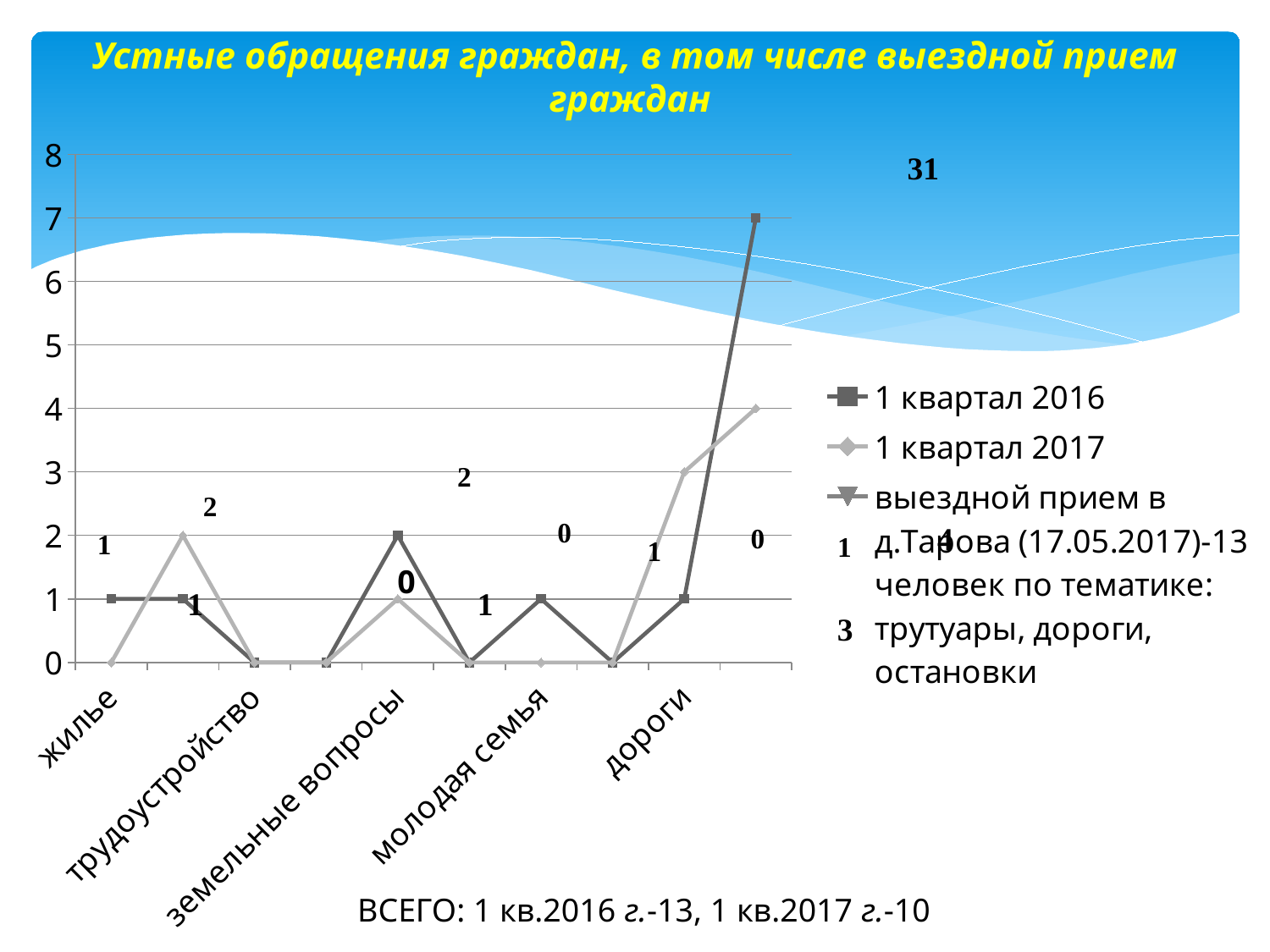
What is the difference between 1 квартал 2017 and 1 квартал 2016 at дороги? 2 How many category labels are shown on the x axis? 5 What is the value for 1 квартал 2016 at жилье? 1 What is the value for 1 квартал 2016 at земельные вопросы? 2 What is the highest value reached by the 1 квартал 2016 line? 7 What is the value for 1 квартал 2017 at жилье? 0 What is the value for 1 квартал 2017 at дороги? 3 What is the value for 1 квартал 2016 at трудоустройство? 0 What is the highest value reached by the 1 квартал 2017 line? 4 At дороги, which series has the larger value, 1 квартал 2016 or 1 квартал 2017? 1 квартал 2017 What kind of chart is shown on the slide? line chart How many series does the legend list? 3